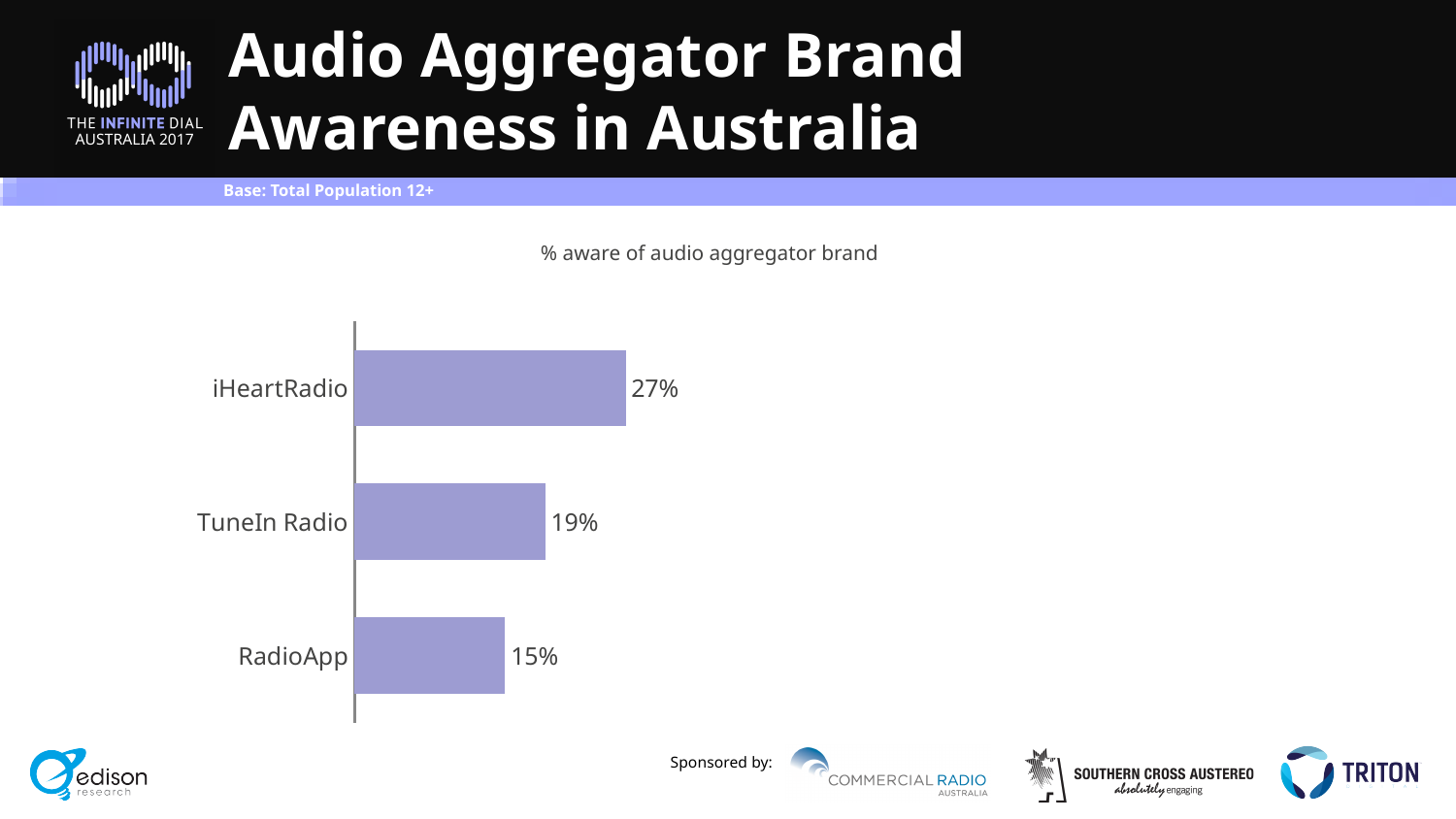
How many audio aggregator brands are shown in the chart? 3 Which audio aggregator brand has the lowest awareness? RadioApp What type of chart is shown on the slide? Bar chart What is the difference in awareness between TuneIn Radio and RadioApp? 4 percentage points What percentage of respondents are aware of RadioApp? 15% Which brand has higher awareness, TuneIn Radio or RadioApp? TuneIn Radio What is the difference in awareness between iHeartRadio and TuneIn Radio? 8 percentage points What percentage of respondents are aware of TuneIn Radio? 19% What is the base population stated for the chart? Total Population 12+ What percentage of respondents are aware of iHeartRadio? 27% What does the chart's subtitle say the bars represent? % aware of audio aggregator brand Which audio aggregator brand has the highest awareness? iHeartRadio